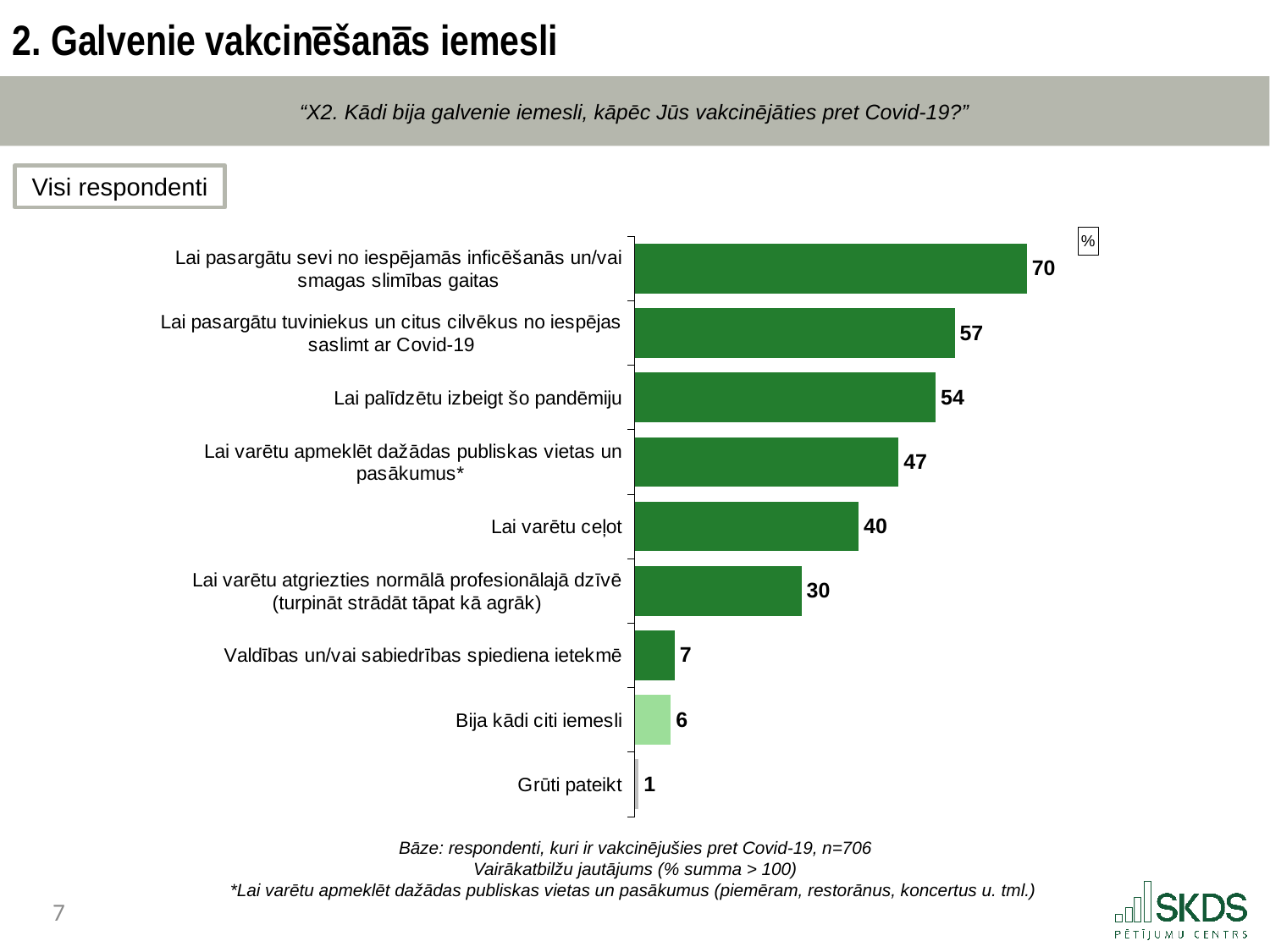
Which is larger: the value for "Lai varētu apmeklēt dažādas publiskas vietas un pasākumus*" or the value for "Lai varētu ceļot"? Lai varētu apmeklēt dažādas publiskas vietas un pasākumus* Which category has the lowest value? Grūti pateikt How many categories are shown in the chart? 9 What is the value for "Lai palīdzētu izbeigt šo pandēmiju"? 54 What is the value for "Bija kādi citi iemesli"? 6 What is the difference between the values for "Lai pasargātu sevi no iespējamās inficēšanās un/vai smagas slimības gaitas" and "Lai pasargātu tuviniekus un citus cilvēkus no iespējas saslimt ar Covid-19"? 13 What is the value for "Lai varētu ceļot"? 40 What is the difference between the values for "Lai varētu ceļot" and "Lai varētu atgriezties normālā profesionālajā dzīvē (turpināt strādāt tāpat kā agrāk)"? 10 Which category has the highest value? Lai pasargātu sevi no iespējamās inficēšanās un/vai smagas slimības gaitas What is the sample size (n) stated in the base note below the chart? n=706 What kind of chart is shown on the slide? Bar chart What is the value for "Valdības un/vai sabiedrības spiediena ietekmē"? 7